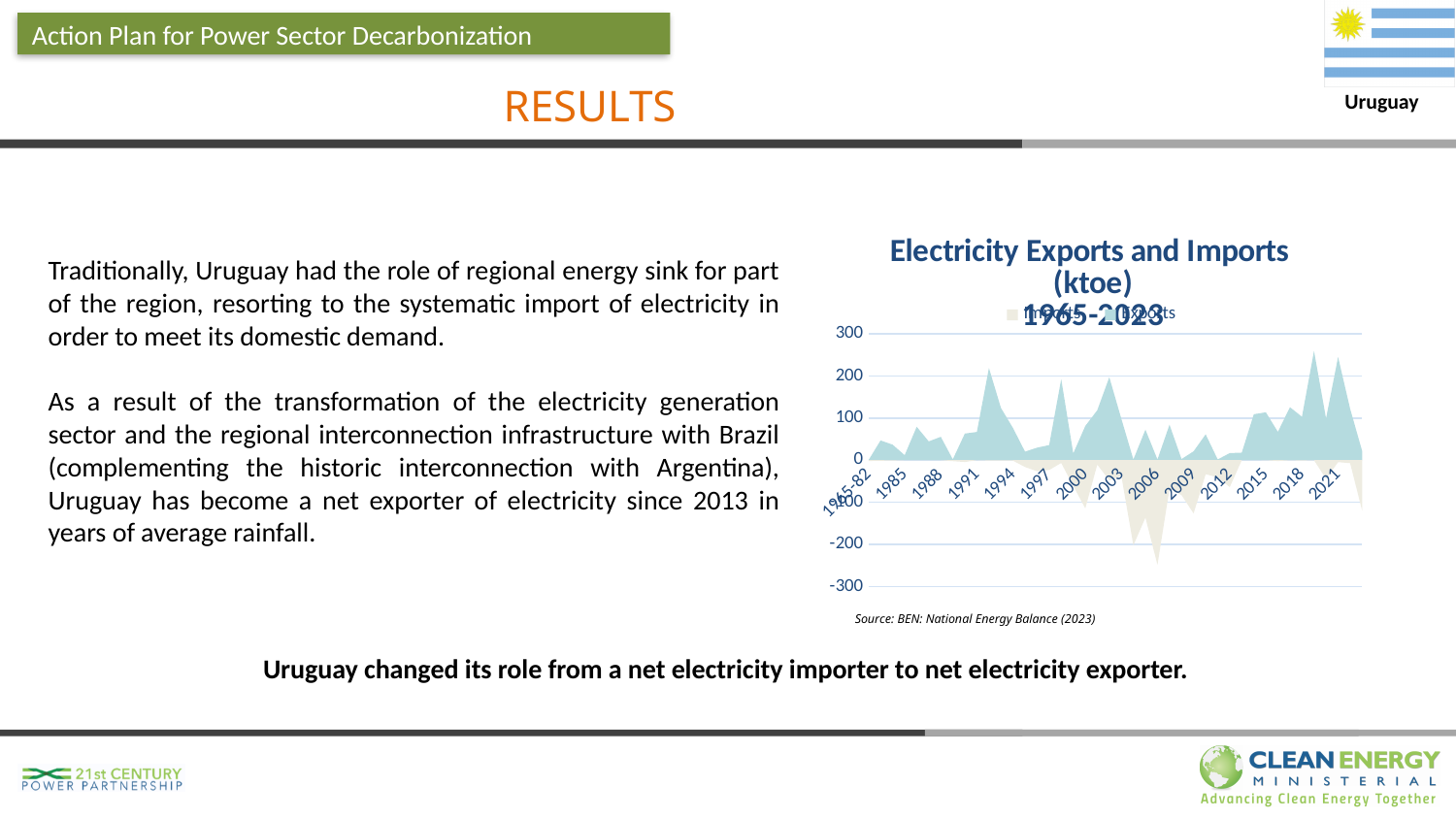
What source is cited below the chart? BEN: National Energy Balance (2023) What is the highest value shown on the chart's vertical axis? 300 What is the lowest value shown on the chart's vertical axis? -300 Is the lowest point of the tan area around 2007 greater or less than -200? less What is the first label on the chart's horizontal axis? 1965-82 What unit is given in the chart title? ktoe Is the peak of the light blue area around 2019 greater or less than 200? greater How many tick labels are shown on the chart's vertical axis? 7 What kind of chart is shown on the slide? Area chart Is the peak of the light blue area around 1992 greater or less than 100? greater What is the title of the chart on the slide? Electricity Exports and Imports (ktoe) 1965-2023 What is the last label on the chart's horizontal axis? 2021